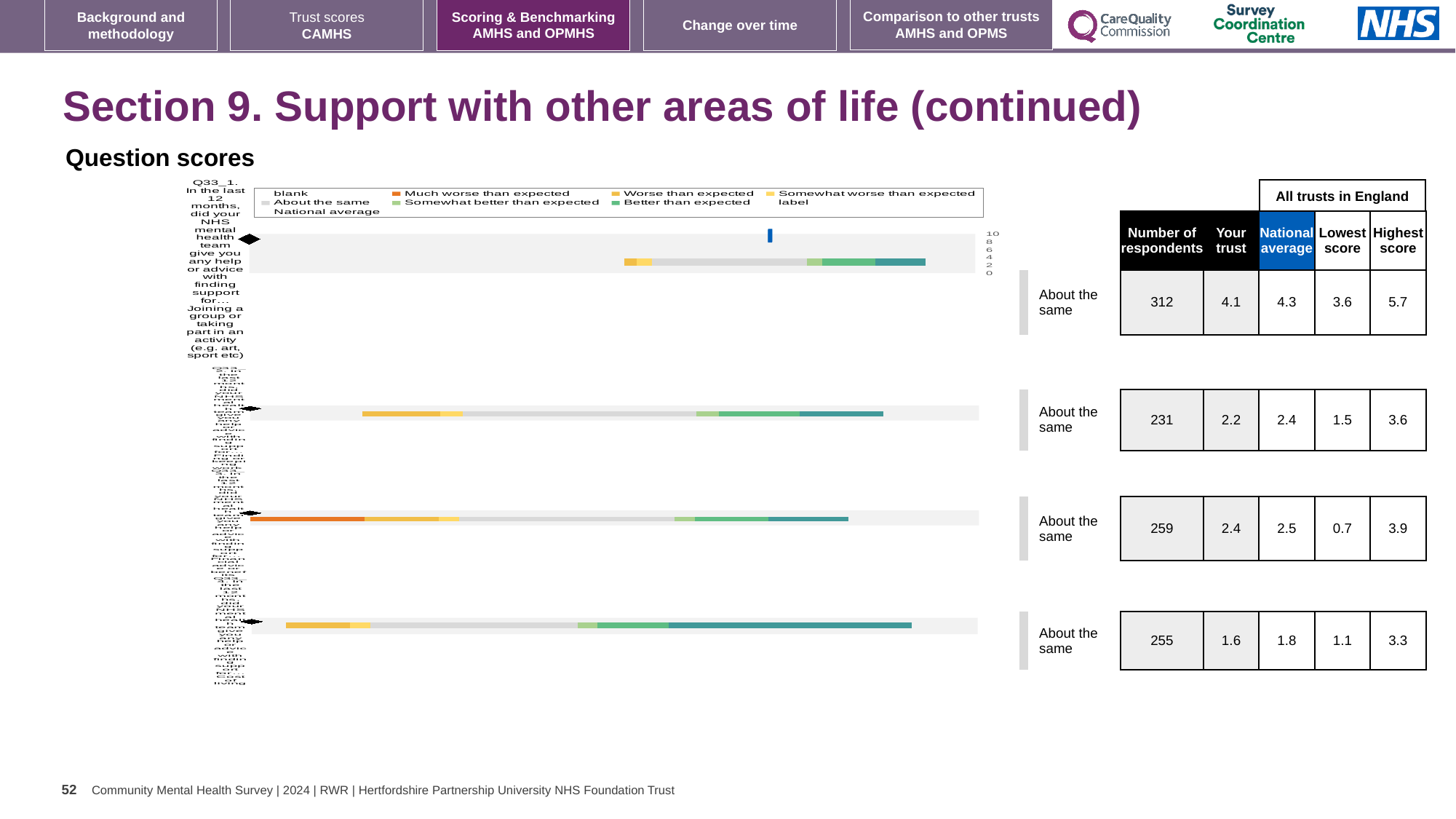
In the table beside the chart, which row has the highest 'Your trust' score? the first row (Q33_1, joining a group or taking part in an activity) What benchmark category is shown for every row of the chart? About the same In the table beside the chart, which row has the lowest 'Lowest score' value? the third row (0.7) In the table beside the chart, what is the difference between the national average and the 'Your trust' score for the first row (Q33_1)? 0.2 In the table beside the chart, for the second row, which is larger: the 'Your trust' score or the national average? national average In the table beside the chart, what is the national average for the bottom row? 1.8 What kind of chart is shown under 'Question scores'? bar chart In the table beside the chart, what is the number of respondents for the first row (Q33_1)? 312 What colour does the legend use for 'About the same'? grey In the table beside the chart, what is the 'Your trust' score for the first row (Q33_1, joining a group or taking part in an activity)? 4.1 What colour does the legend use for 'Much worse than expected'? orange How many question rows (bars) are plotted in the chart? 4